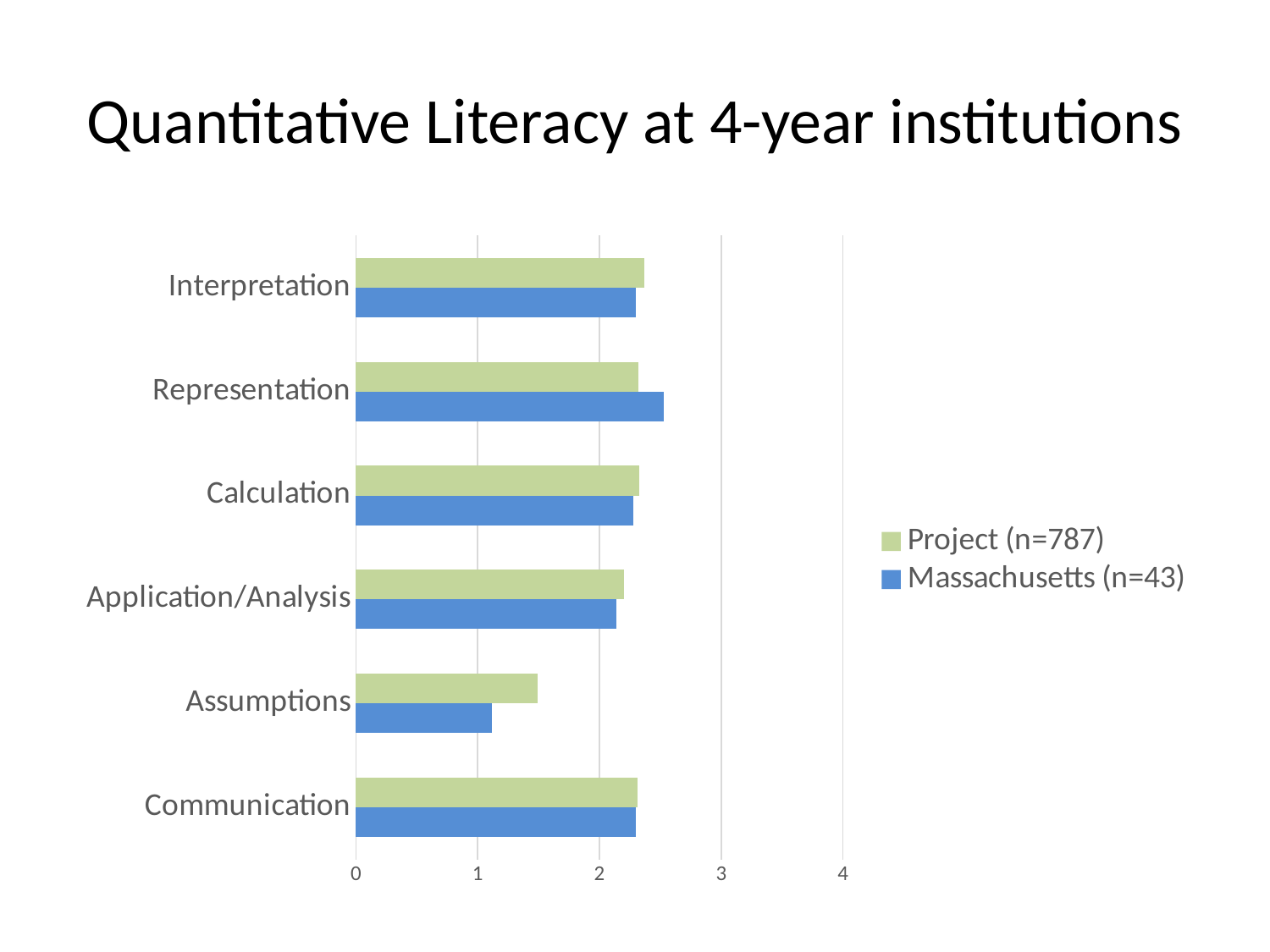
How many series does the legend list? 2 Which category has the lowest value for the Project (n=787) series? Assumptions For Assumptions, which series has the larger value, Project (n=787) or Massachusetts (n=43)? Project (n=787) Which category has the highest value for the Massachusetts (n=43) series? Representation What kind of chart is shown on the slide? bar chart Is the Project (n=787) value for Interpretation greater or less than 3? less Is the Project (n=787) value for Assumptions greater or less than 2? less How many categories are shown on the chart? 6 Is the Massachusetts (n=43) value for Representation greater or less than 2? greater Which series is shown in blue in the legend? Massachusetts (n=43) Which category has the lowest value for the Massachusetts (n=43) series? Assumptions For Representation, which series has the larger value, Project (n=787) or Massachusetts (n=43)? Massachusetts (n=43)